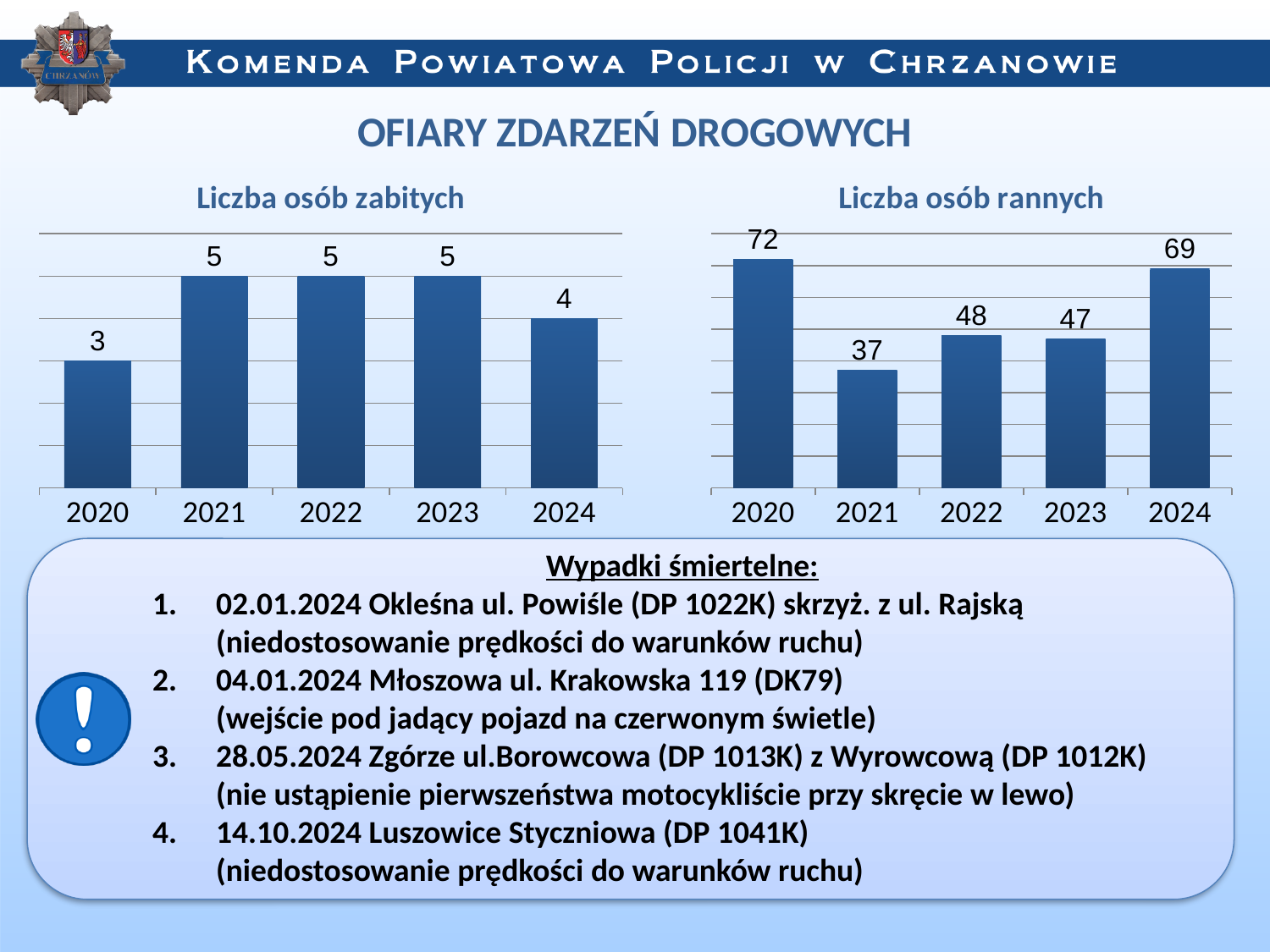
In the 'Liczba osób rannych' chart, which year has the lowest value? 2021 In the 'Liczba osób rannych' chart, which is larger: the value for 2022 or the value for 2024? 2024 In the 'Liczba osób rannych' chart, which year has the highest value? 2020 In the 'Liczba osób rannych' chart, what is the difference between the values for 2020 and 2021? 35 In the 'Liczba osób rannych' chart, what is the value for 2021? 37 In the 'Liczba osób zabitych' chart, which year has the lowest value? 2020 In the 'Liczba osób zabitych' chart, what is the difference between the values for 2023 and 2024? 1 What kind of chart is the 'Liczba osób zabitych' chart? Bar chart In the 'Liczba osób zabitych' chart, what is the value for 2020? 3 In the 'Liczba osób rannych' chart, what is the value for 2024? 69 In the 'Liczba osób zabitych' chart, what is the value for 2024? 4 How many years are shown in the 'Liczba osób rannych' chart? 5